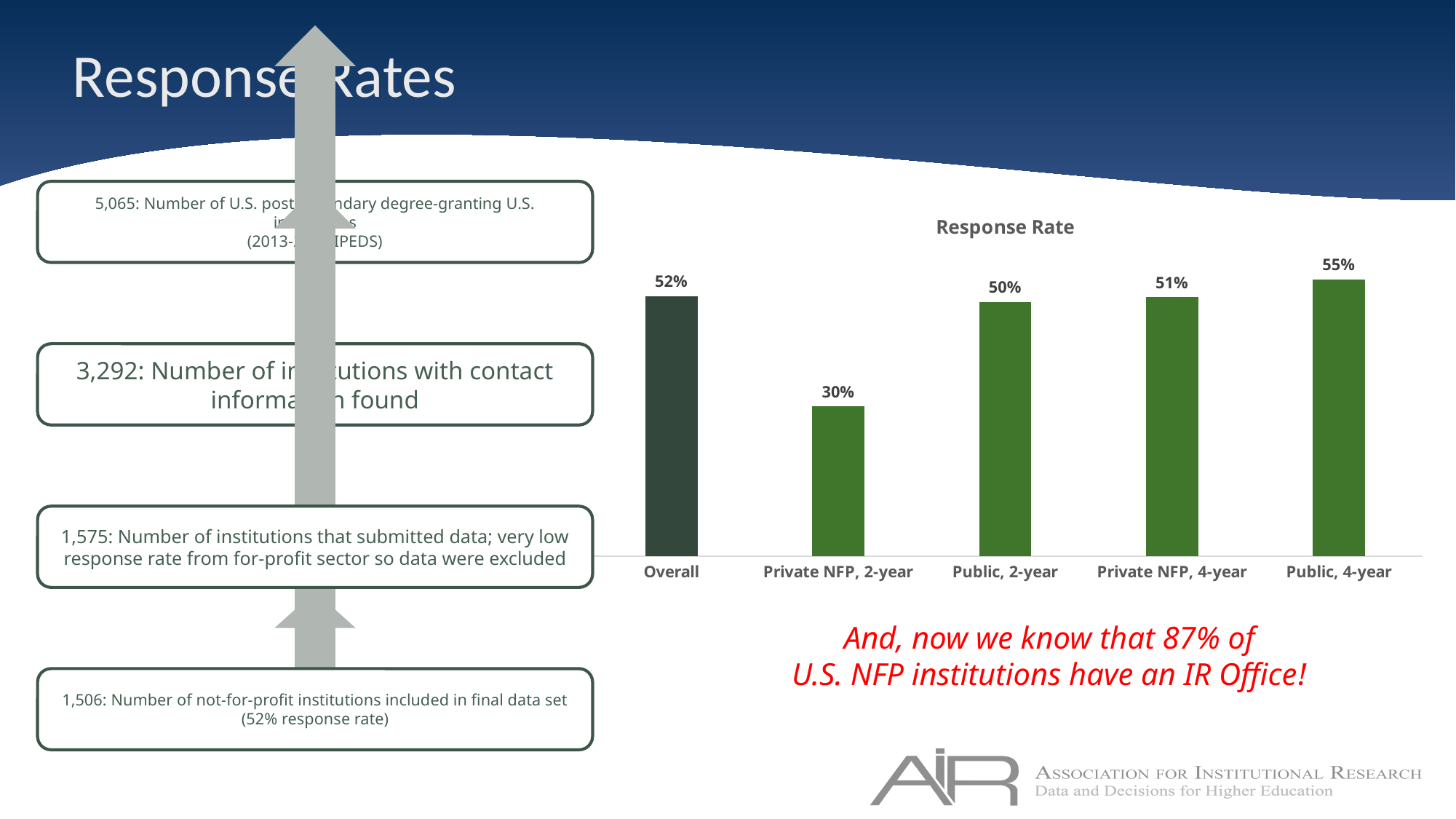
What is the response rate for Private NFP, 4-year? 51% What is the response rate for Public, 4-year? 55% Which category has the highest response rate? Public, 4-year What is the difference between the response rates for Public, 4-year and Private NFP, 2-year? 25% What is the Overall response rate shown in the chart? 52% What is the title of the chart? Response Rate Which has a higher response rate, Public, 2-year or Private NFP, 2-year? Public, 2-year What is the response rate for Private NFP, 2-year? 30% Which category has the lowest response rate? Private NFP, 2-year How many categories are shown in the Response Rate chart? 5 What is the difference between the Overall response rate and the Public, 2-year response rate? 2% What type of chart is used to show the response rates? Bar chart